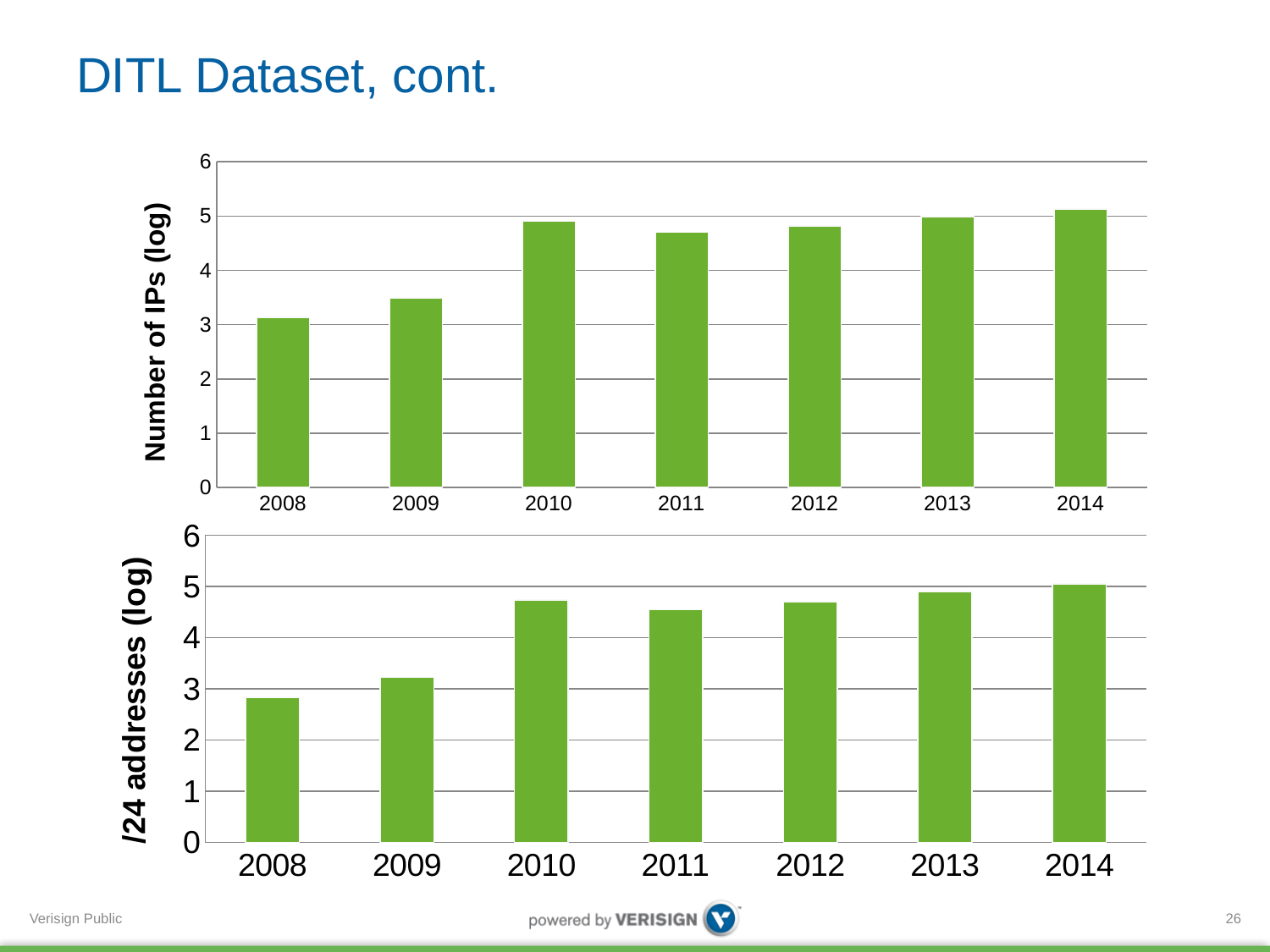
In the bottom chart (/24 addresses), which year has the highest bar? 2014 In the top chart (Number of IPs), is the value for 2008 greater or less than 3? greater In the top chart (Number of IPs), is the value for 2014 greater or less than 5? greater In the top chart (Number of IPs), which is larger, the value for 2009 or the value for 2010? 2010 In the bottom chart (/24 addresses), do the values rise or fall from 2008 to 2010? rise In the bottom chart (/24 addresses), which year has the lowest bar? 2008 What is the y-axis label of the bottom chart? /24 addresses (log) What kind of chart is the top chart on the slide? bar chart How many years are shown on the x axis of the bottom chart? 7 In the top chart (Number of IPs), which year has the highest bar? 2014 In the bottom chart (/24 addresses), is the value for 2008 greater or less than 3? less In the top chart (Number of IPs), which year has the lowest bar? 2008